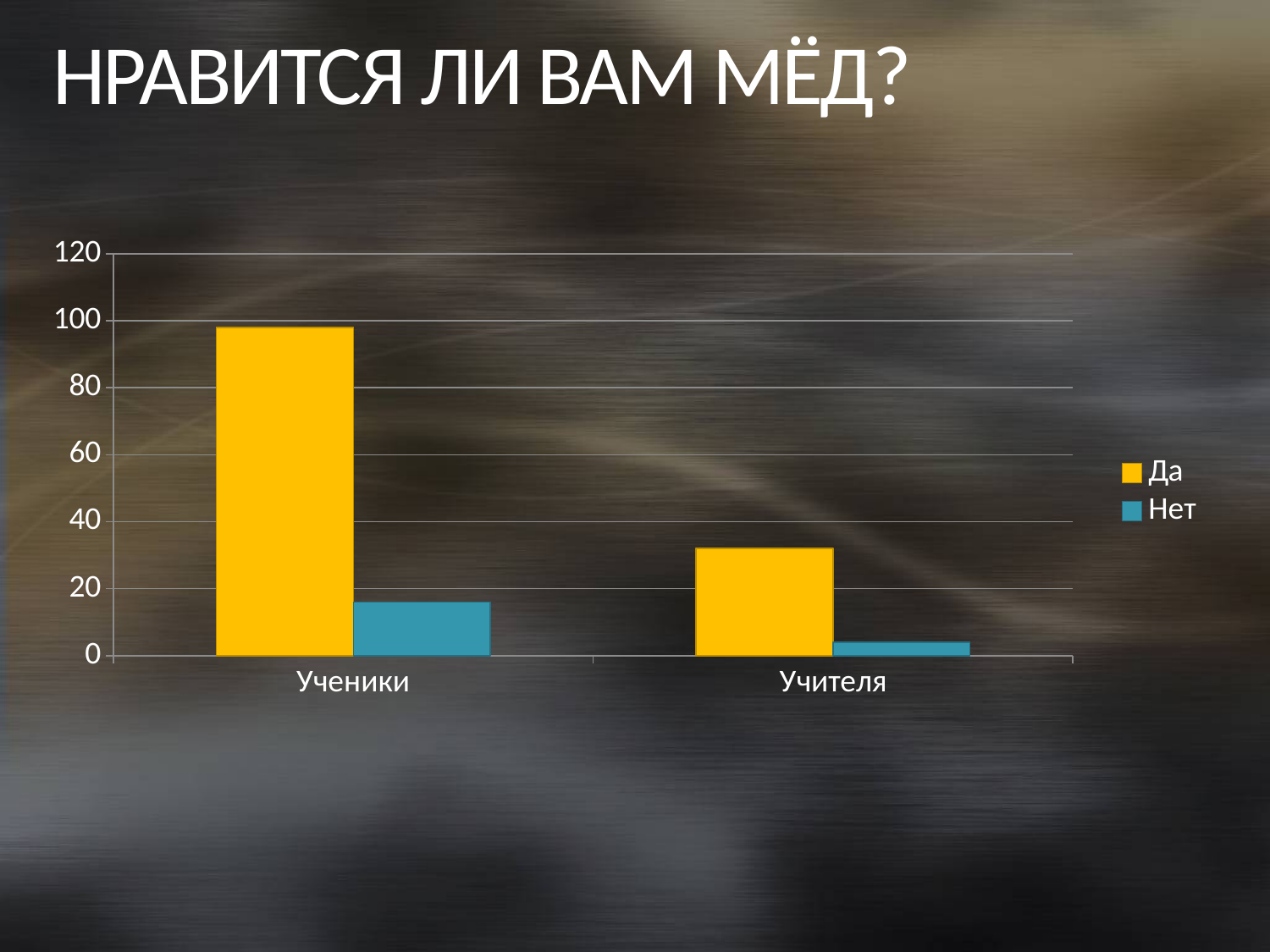
Is the value for Да among Учителя greater or less than 20? greater Is the value for Да among Учителя greater or less than 40? less Which is larger: the Да value for Ученики or the Да value for Учителя? Ученики What kind of chart is shown on the slide? bar chart How many categories are shown on the x axis? 2 Is the value for Нет among Ученики greater or less than 20? less Which bar is the lowest in the chart? Нет for Учителя How many series does the legend list? 2 Which category has the tallest bar in the chart? Ученики Which colour represents the Нет series in the legend? blue What is the title of the slide's chart? НРАВИТСЯ ЛИ ВАМ МЁД?